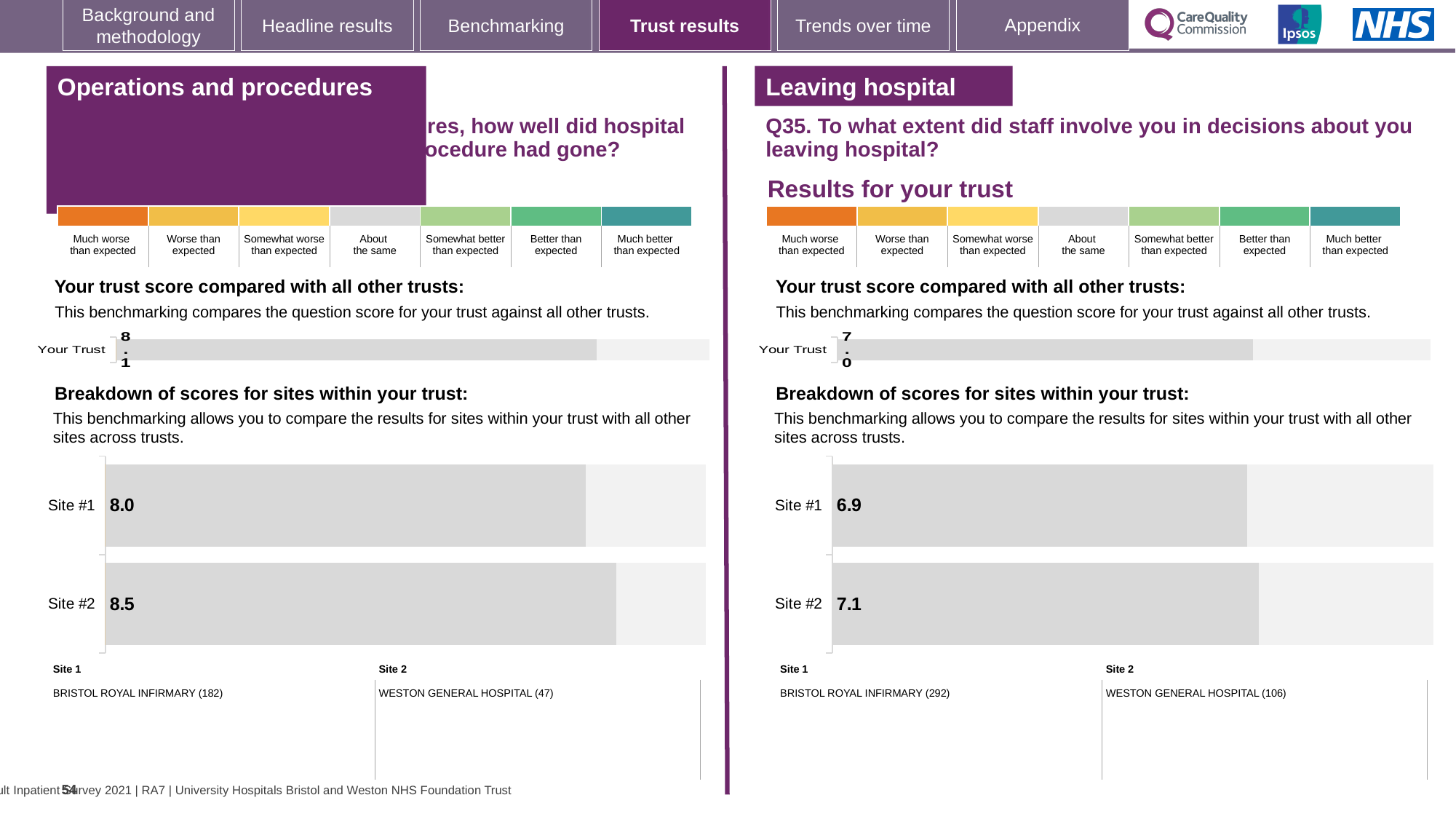
In the 'Leaving hospital' breakdown of scores for sites chart, which site has the lower score? Site #1 In the 'Leaving hospital' section, what is the score for Site #1 in the breakdown of scores for sites chart? 6.9 In the 'Operations and procedures' breakdown of scores for sites chart, what is the difference between the Site #2 and Site #1 scores? 0.5 In the 'Operations and procedures' section, what is the score for Site #1 in the breakdown of scores for sites chart? 8.0 What type of chart is used for the breakdown of scores for sites in the 'Operations and procedures' section? Bar chart How many sites are shown in the 'Leaving hospital' breakdown of scores for sites chart? 2 In the 'Operations and procedures' breakdown of scores for sites chart, which site has the higher score? Site #2 In the 'Leaving hospital' section, what is the 'Your Trust' score shown in the trust comparison chart? 7.0 In the 'Operations and procedures' section, what is the 'Your Trust' score shown in the trust comparison chart? 8.1 In the 'Leaving hospital' section, what is the score for Site #2 in the breakdown of scores for sites chart? 7.1 In the 'Leaving hospital' breakdown of scores for sites chart, what is the difference between the Site #2 and Site #1 scores? 0.2 In the 'Operations and procedures' section, what is the score for Site #2 in the breakdown of scores for sites chart? 8.5